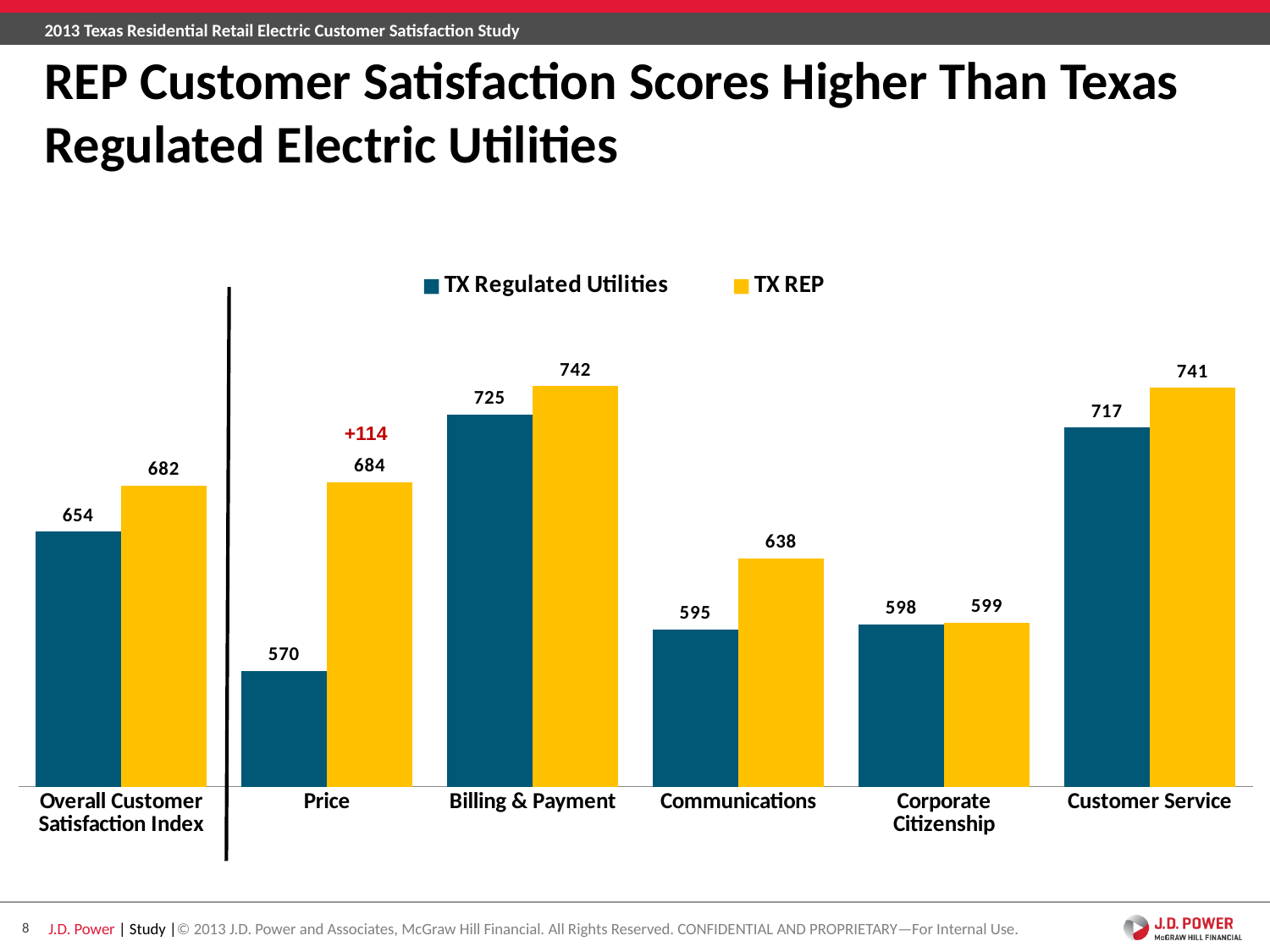
Which is larger for Customer Service: TX Regulated Utilities or TX REP? TX REP What is the TX REP value for Price? 684 How many categories are shown on the x axis? 6 What is the difference between the TX REP and TX Regulated Utilities values for Communications? 43 What kind of chart is shown on the slide? Bar chart Which series is shown in yellow? TX REP How many series does the legend list? 2 What is the difference between the TX REP and TX Regulated Utilities values for Price? 114 What is the TX REP value for the Overall Customer Satisfaction Index? 682 Which category has the lowest TX Regulated Utilities value? Price Which category has the highest TX REP value? Billing & Payment What is the TX Regulated Utilities value for Communications? 595